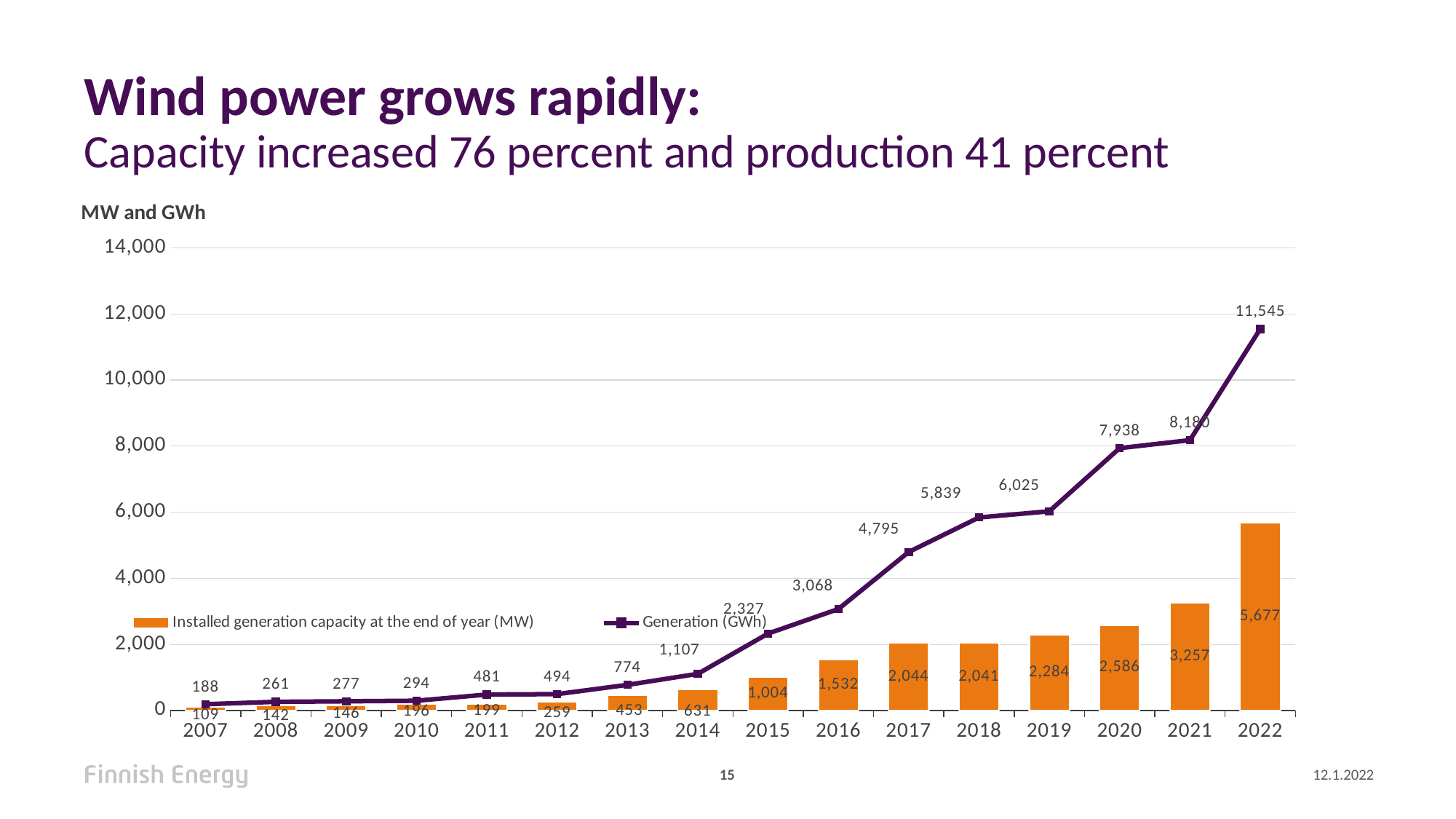
What was the installed generation capacity at the end of 2015 in MW? 1,004 Which year has the highest generation (GWh)? 2022 Is the generation (GWh) in 2020 greater or less than 8,000? less How many series does the legend list? 2 What is the overall trend of generation (GWh) from 2007 to 2022? rising What was the installed generation capacity at the end of 2022 in MW? 5,677 By how much did generation (GWh) increase from 2021 to 2022? 3,365 What is the difference in installed generation capacity (MW) between 2022 and 2021? 2,420 Which year has the lowest installed generation capacity (MW)? 2007 What was the wind power generation in GWh in 2021? 8,180 How many years are shown on the x axis? 16 Which is larger: the installed capacity (MW) in 2017 or in 2018? 2017